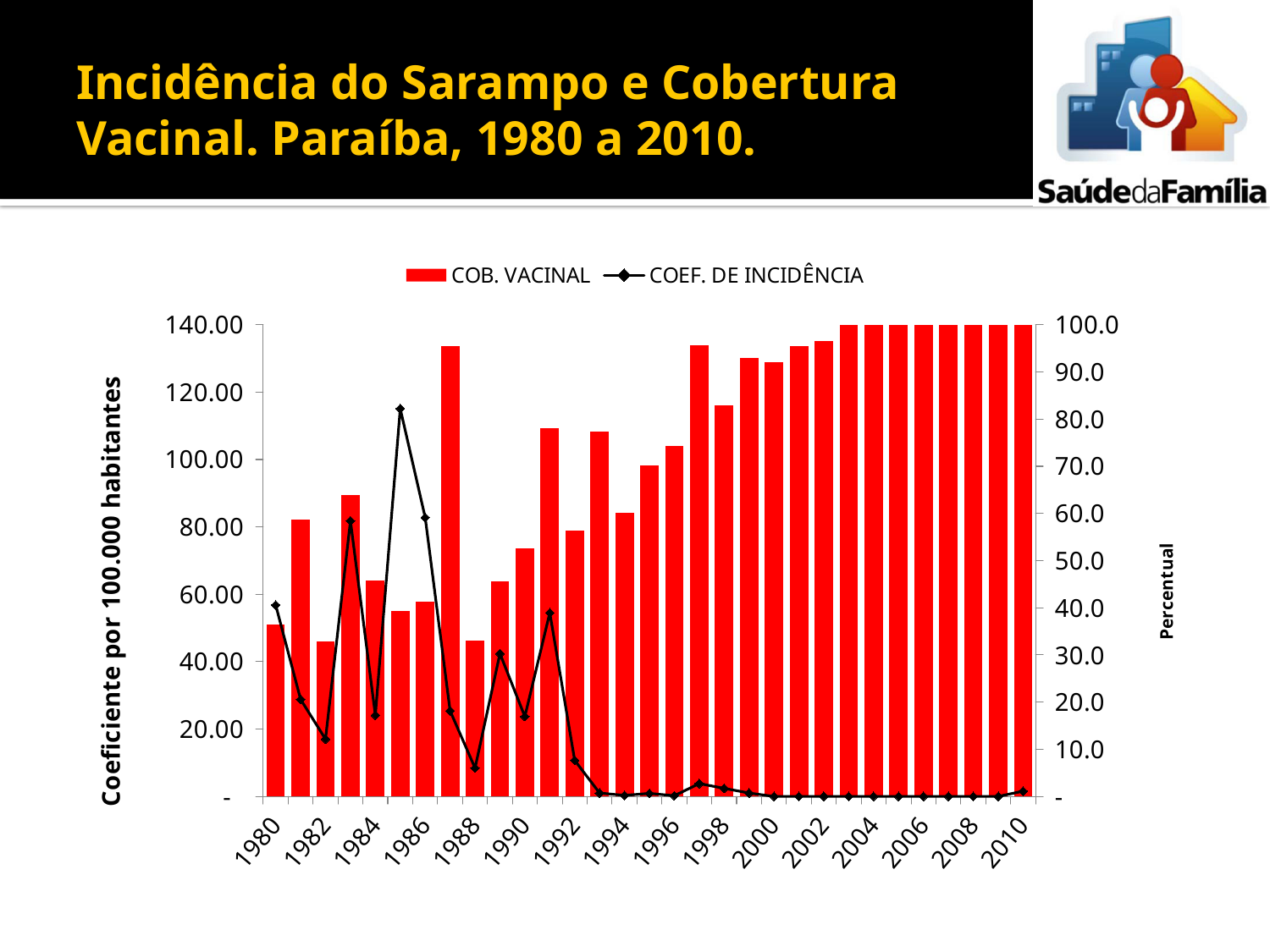
In which year does the COEF. DE INCIDÊNCIA line reach its highest value? 1985 How many series does the legend list? 2 Is the COEF. DE INCIDÊNCIA value for 1985 greater or less than 100.00? greater How many years are plotted along the x axis? 31 What is the title of the right-hand vertical axis? Percentual Which year has the larger COB. VACINAL bar, 1987 or 1988? 1987 Is the COB. VACINAL value for 1987 greater or less than 90.0? greater Is the COB. VACINAL value for 1989 greater or less than 50.0? less Overall, does the COEF. DE INCIDÊNCIA line rise or fall from 1980 to 2010? fall Overall, do the COB. VACINAL bars rise or fall from 1980 to 2010? rise What kind of chart is shown on the slide? A combined bar and line chart